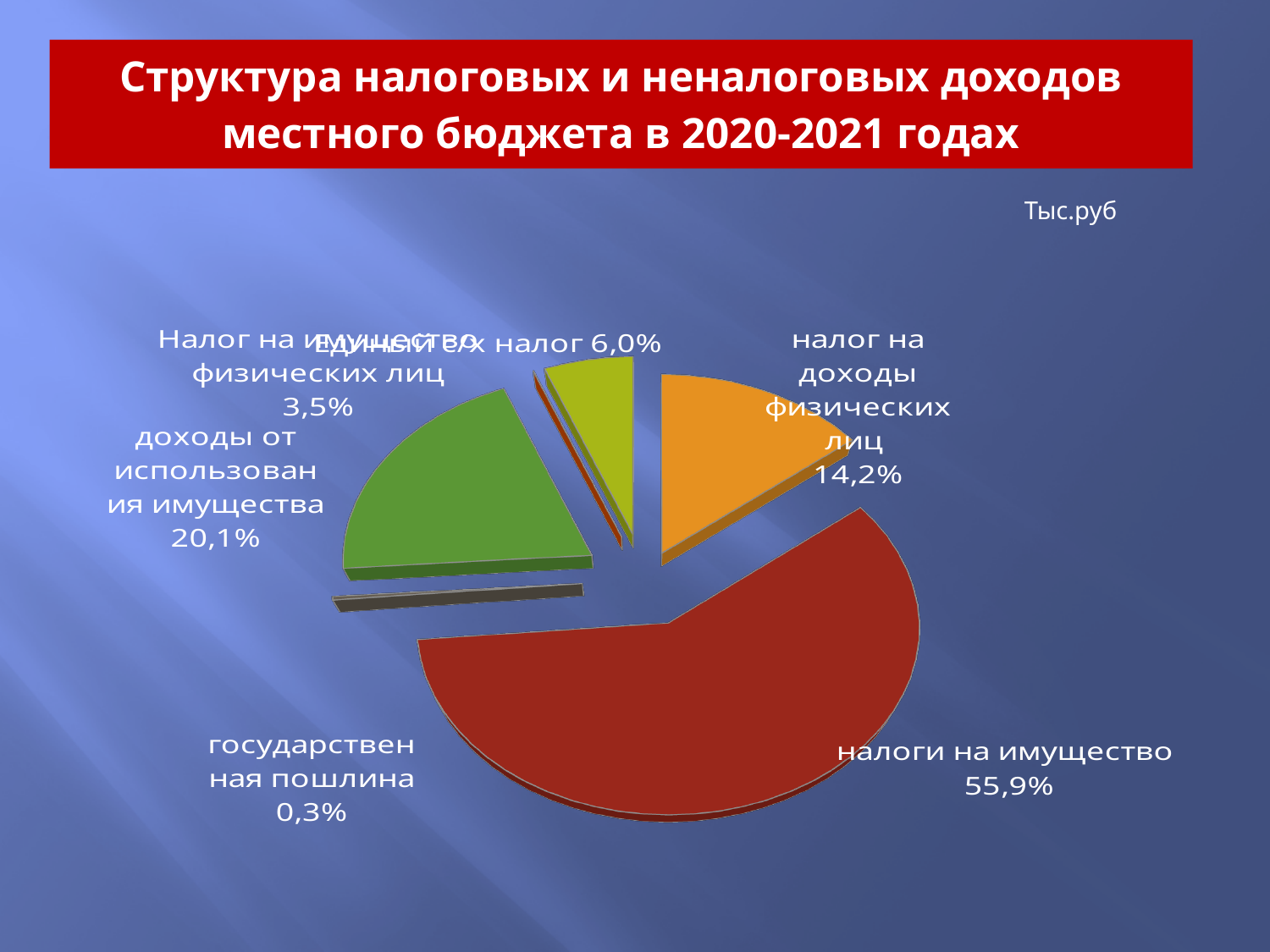
What share of the pie is labelled for налог на доходы физических лиц? 14,2% What is the difference between the shares of налоги на имущество and доходы от использования имущества? 35,8% What kind of chart is shown on the slide? pie chart Which category has the largest share of the pie? налоги на имущество What share of the pie is labelled for налоги на имущество? 55,9% How many slices does the pie chart have? 6 What unit is indicated in the top right of the slide above the chart? Тыс.руб What share of the pie is labelled for государственная пошлина? 0,3% Which category has the smallest share of the pie? государственная пошлина Which is larger: the share of налог на доходы физических лиц or the share of Единый с/х налог? налог на доходы физических лиц